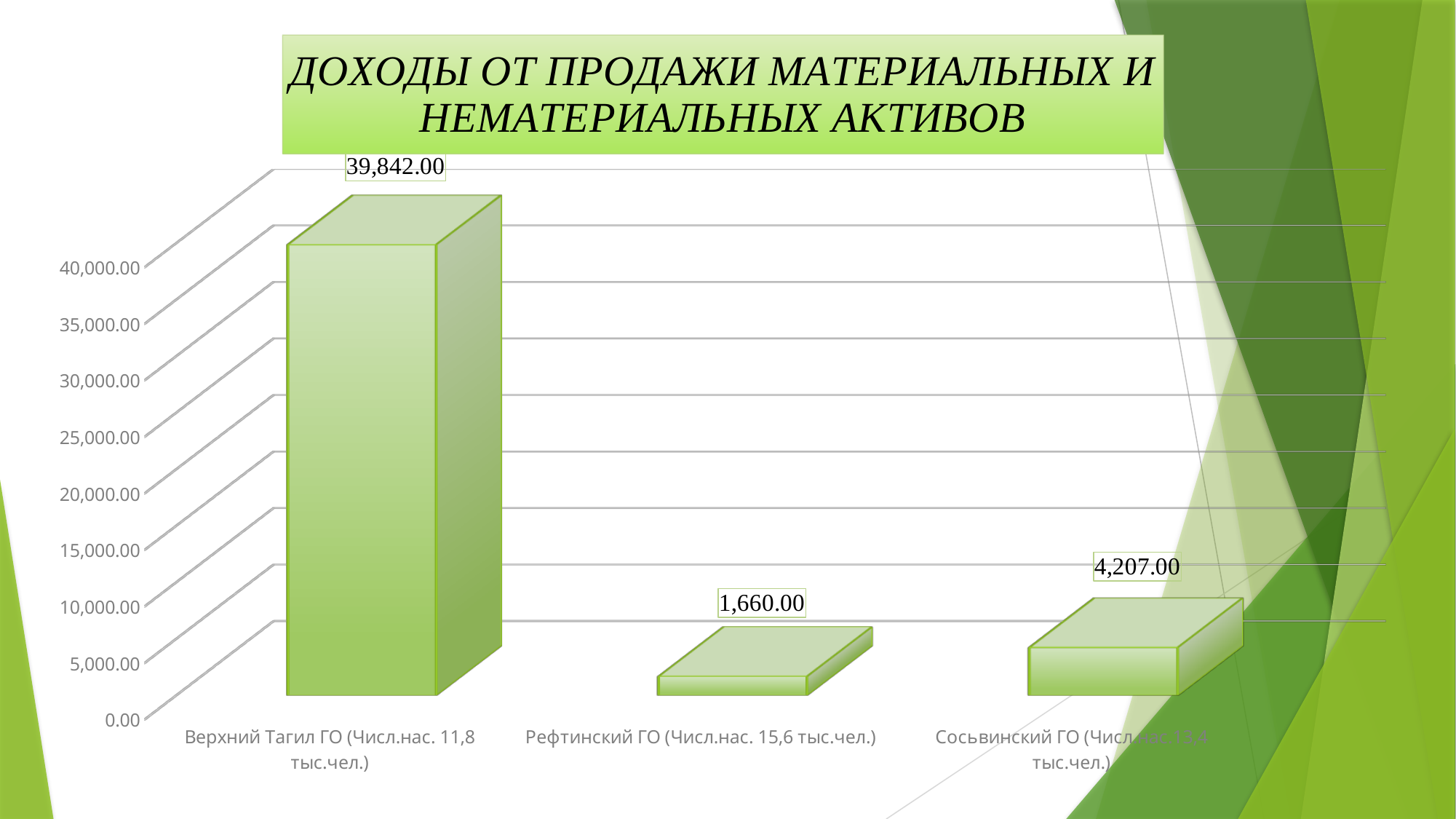
What is the value for Сосьвинский ГО? 4,207.00 Which is larger, the value for Рефтинский ГО or the value for Сосьвинский ГО? Сосьвинский ГО What is the value for Верхний Тагил ГО? 39,842.00 What is the difference between the values for Сосьвинский ГО and Рефтинский ГО? 2,547.00 Which category has the highest value? Верхний Тагил ГО How many categories are shown in the chart? 3 Is the value for Верхний Тагил ГО greater or less than 35,000.00? greater What is the title of the chart? ДОХОДЫ ОТ ПРОДАЖИ МАТЕРИАЛЬНЫХ И НЕМАТЕРИАЛЬНЫХ АКТИВОВ What is the difference between the values for Верхний Тагил ГО and Сосьвинский ГО? 35,635.00 What is the value for Рефтинский ГО? 1,660.00 What kind of chart is shown on the slide? bar chart Which category has the lowest value? Рефтинский ГО